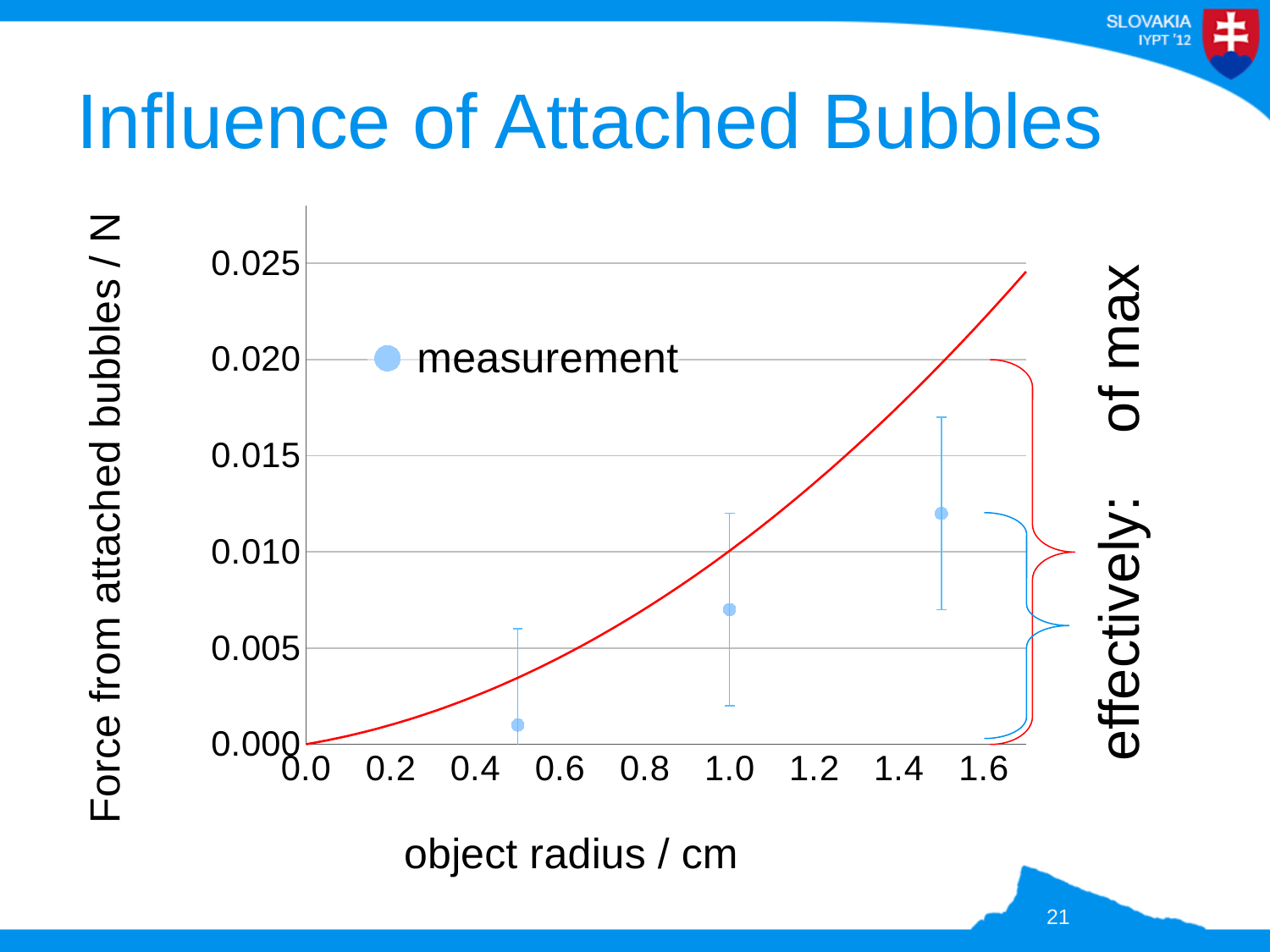
Which has the larger measured force: the point at 1.0 cm or the point at 1.5 cm? 1.5 cm Is the measured force at an object radius of 1.5 cm greater or less than 0.010 N? greater How many series does the chart legend list? 1 Do the measured force values rise or fall as the object radius increases? rise Is the measured force at an object radius of 0.5 cm greater or less than 0.005 N? less At which object radius is the measured force lowest? 0.5 cm What is the label of the series listed in the legend? measurement What is the title of the x axis? object radius / cm Is the measured force at an object radius of 1.0 cm greater or less than 0.010 N? less At which object radius is the measured force highest? 1.5 cm What kind of chart is shown on the slide? scatter chart How many measurement points are plotted on the chart? 3